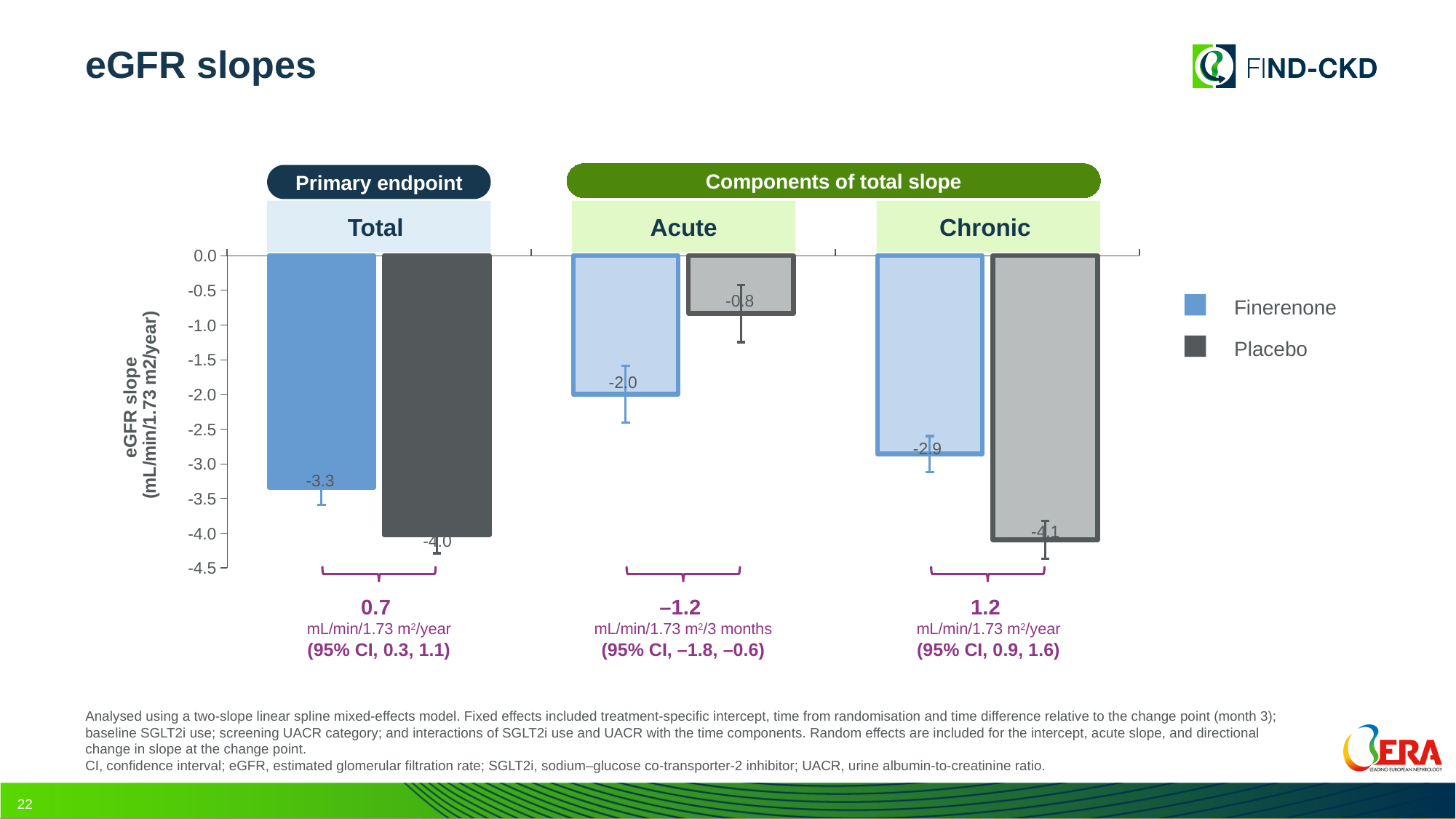
What is the difference between the Finerenone and Placebo values in the Chronic category? 1.2 What kind of chart is shown on the slide? Bar chart Which category has the highest (least negative) Finerenone value? Acute What is the eGFR slope for Finerenone in the Total category? -3.3 What is the eGFR slope for Finerenone in the Acute category? -2.0 What is the eGFR slope for Placebo in the Chronic category? -4.1 How many categories are shown on the x axis? 3 Is the Placebo value in the Acute category greater or less than -1.0? greater Which category has the lowest (most negative) Placebo value? Chronic What is the eGFR slope for Placebo in the Total category? -4.0 In the Acute category, which is more negative: Finerenone or Placebo? Finerenone How many series does the legend list? 2